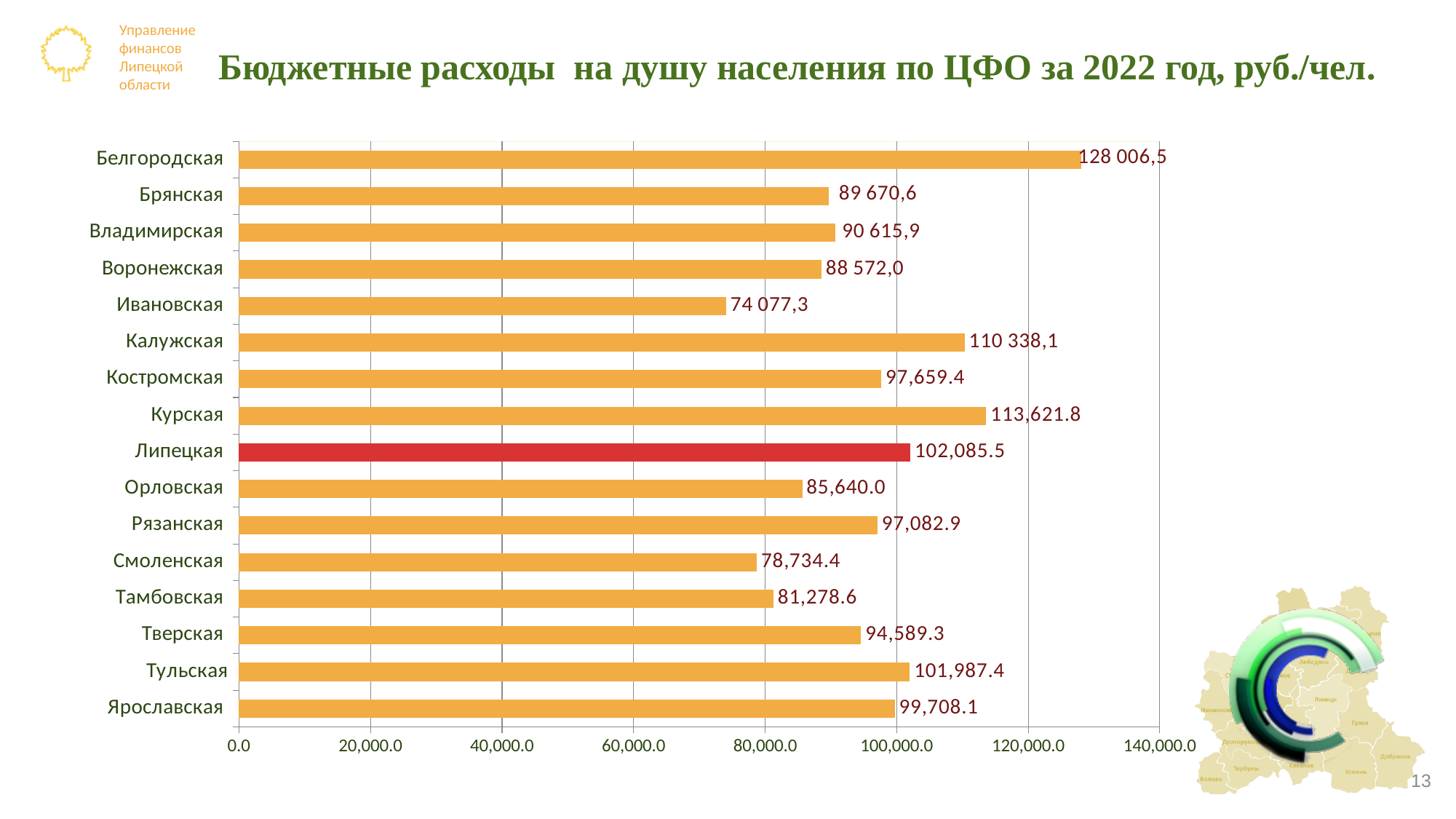
What is the value for Липецкая? 102,085.5 Is the value for Смоленская greater or less than 80,000.0? less What is the value for Тульская? 101,987.4 What is the value for Ивановская? 74 077,3 How many regions are shown in the chart? 16 What kind of chart is shown on the slide? bar chart What is the difference between the values for Курская and Липецкая? 11,536.3 Which region has the lowest value? Ивановская Which region has the highest value? Белгородская Which has the larger value, Калужская or Курская? Курская What is the value for Белгородская? 128 006,5 Which region's bar is shown in a different colour (red) from the others? Липецкая